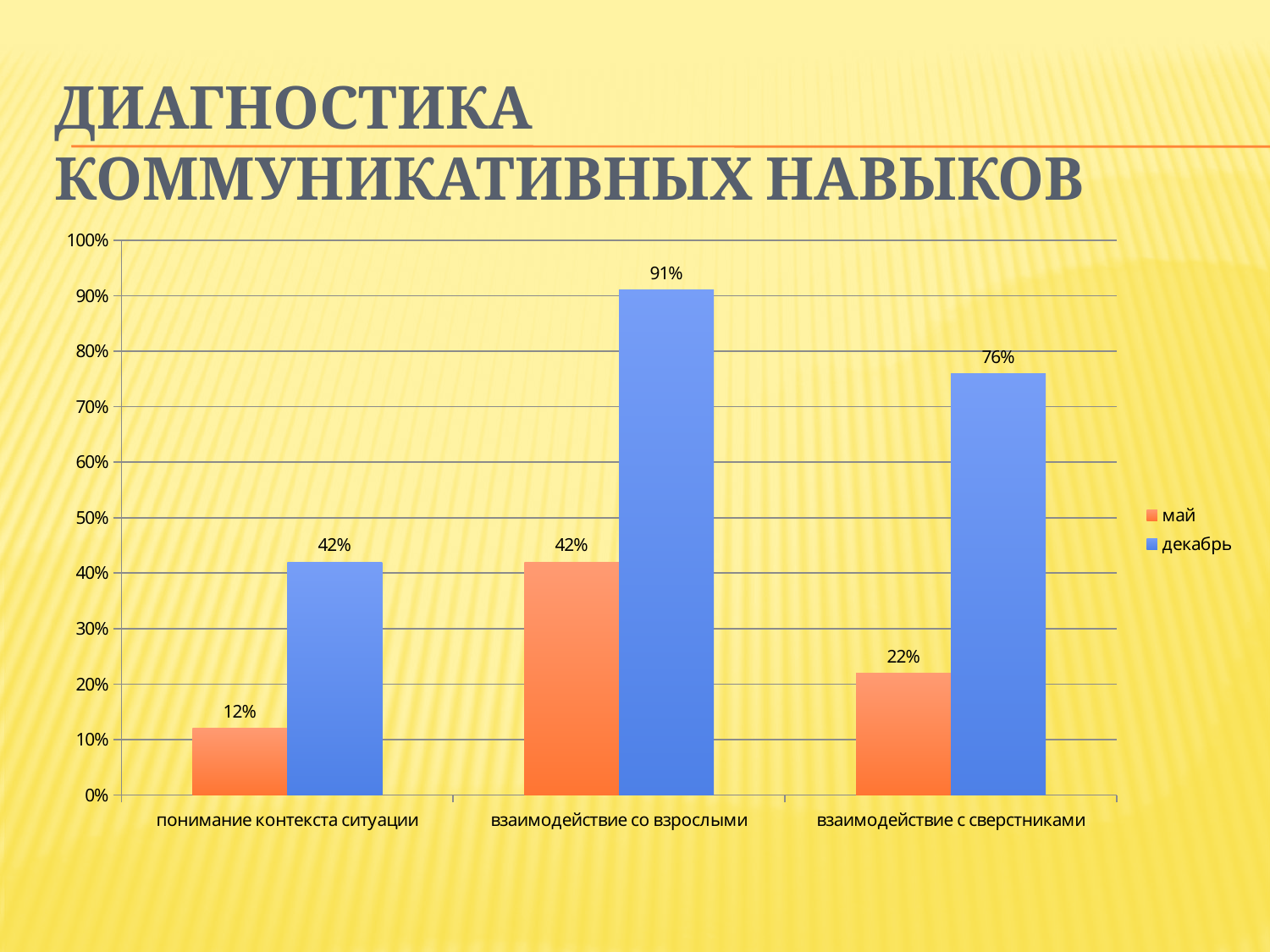
What is the value for "декабрь" in the category "взаимодействие с сверстниками"? 76% How many categories are shown on the x axis? 3 Which category has the highest value for "декабрь"? взаимодействие со взрослыми What is the value for "май" in the category "взаимодействие с сверстниками"? 22% How many series does the legend list? 2 What is the difference between the "декабрь" and "май" values for "взаимодействие с сверстниками"? 54% Which category has the lowest value for "май"? понимание контекста ситуации What is the value for "декабрь" in the category "взаимодействие со взрослыми"? 91% Which colour represents the "май" series? orange Which is larger: the "май" value for "взаимодействие со взрослыми" or the "май" value for "взаимодействие с сверстниками"? взаимодействие со взрослыми What is the value for "май" in the category "понимание контекста ситуации"? 12% What kind of chart is shown on the slide? bar chart